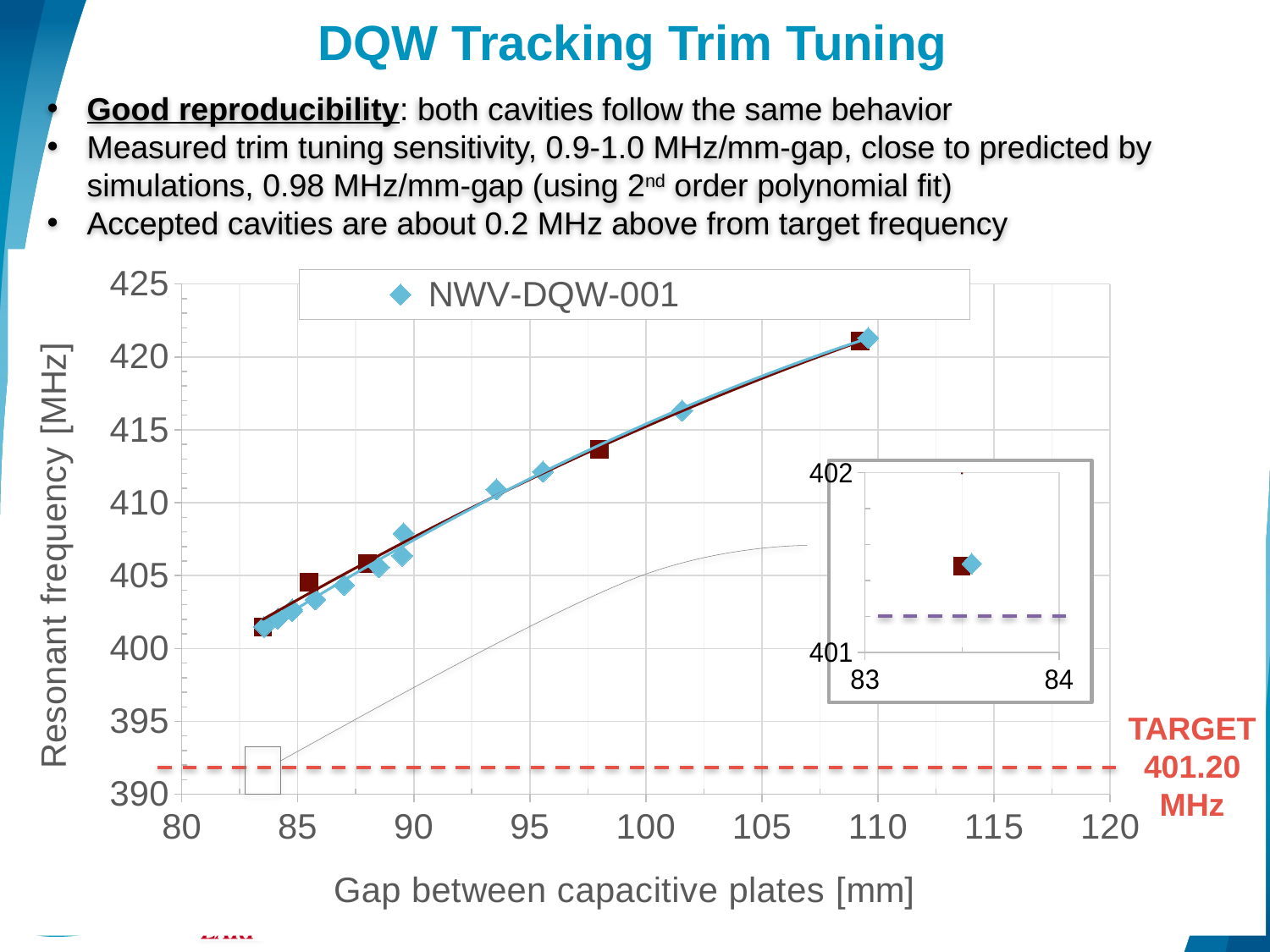
What is the lowest value shown on the y axis of the main chart? 390 What is the title of the y axis of the chart? Resonant frequency [MHz] What kind of chart is shown on the slide? scatter chart Is the resonant frequency at a gap of about 98 mm greater or less than 415 MHz? less Is the resonant frequency at the smallest gap (about 83.5 mm) greater or less than 400 MHz? greater What target frequency is marked by the dashed red line on the chart? 401.20 MHz What is the title of the x axis of the chart? Gap between capacitive plates [mm] Is the resonant frequency at a gap of about 93.5 mm greater or less than 410 MHz? greater What range does the x axis of the inset chart cover? 83 to 84 Which plotted point has the highest resonant frequency: the one at a gap of about 109.5 mm or the one at about 85.5 mm? the one at about 109.5 mm Does the resonant frequency rise or fall as the gap between capacitive plates increases? rise